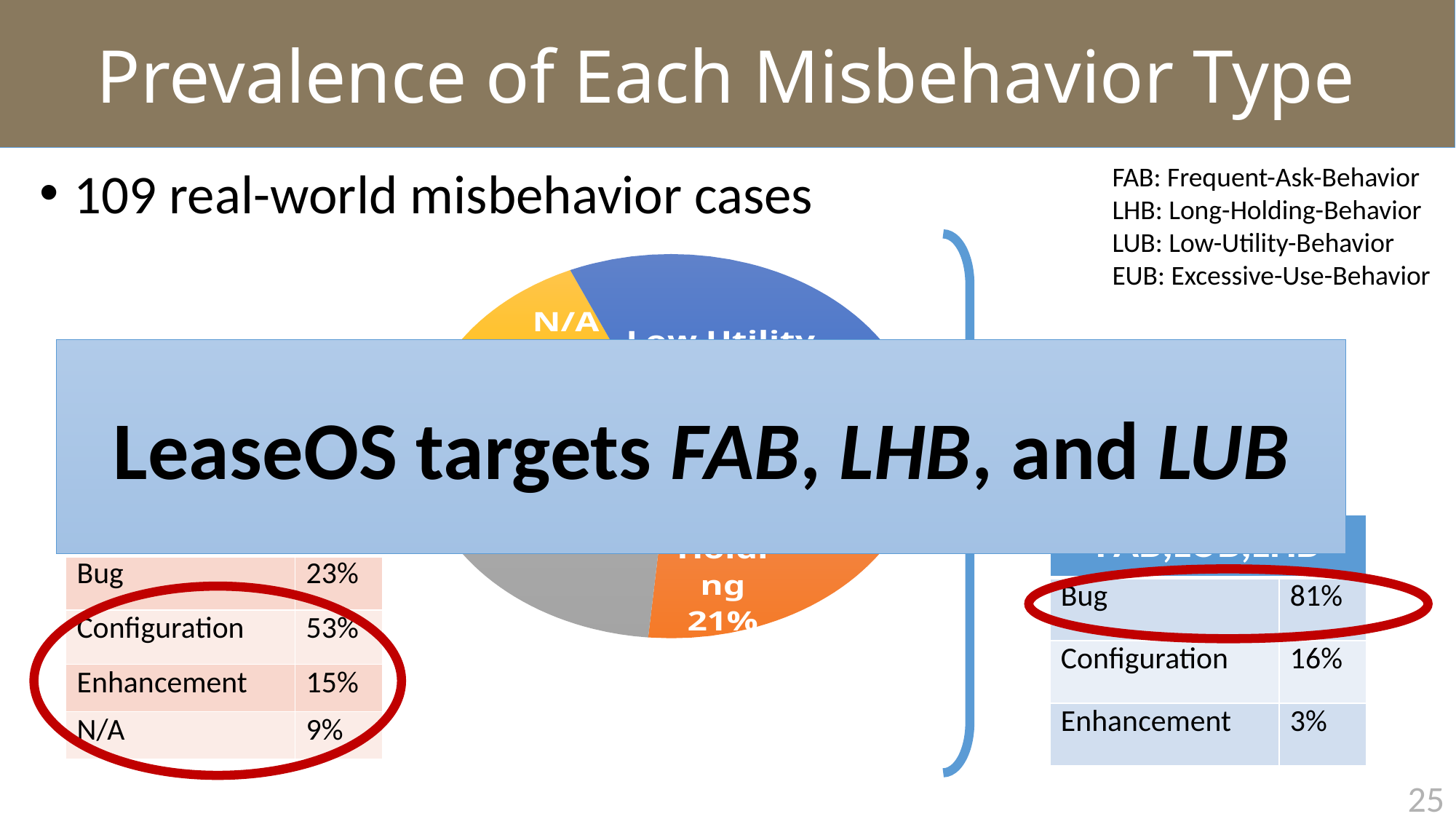
In the pie chart, which slice is larger, the gray slice or the yellow N/A slice? the gray slice What kind of chart is shown in the middle of the slide? pie chart In the pie chart, which slice is larger, the blue Low Utility slice or the yellow N/A slice? the blue Low Utility slice What percentage is printed on the orange slice of the pie chart? 21% What colour is the Low Utility slice of the pie chart? blue What colour is the N/A slice of the pie chart? yellow In the pie chart, which slice is larger, the orange slice or the yellow N/A slice? the orange slice